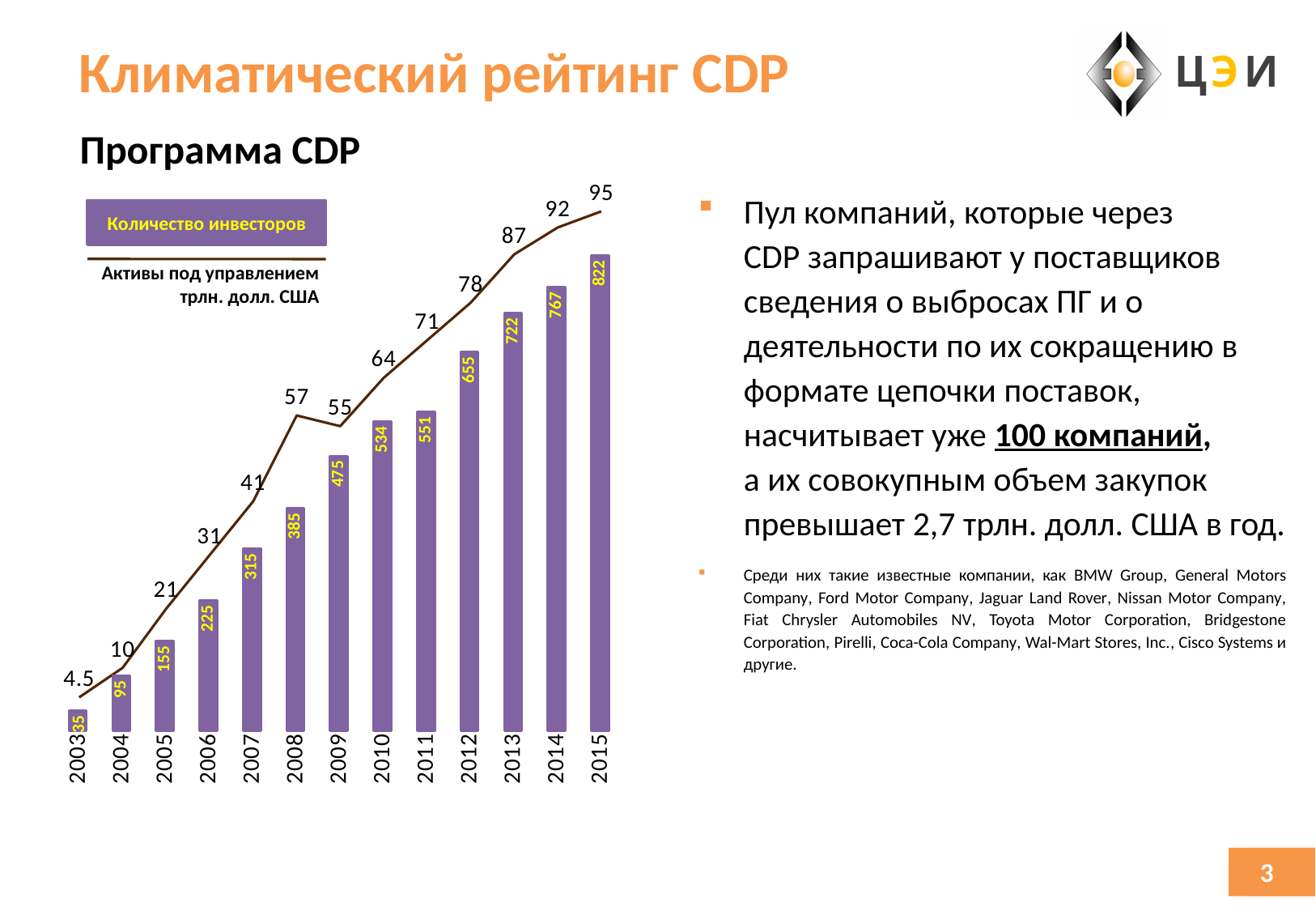
What is the difference in the number of investors between 2015 and 2014? 55 How many years are shown on the x axis? 13 What is the value of assets under management (Активы под управлением) in 2008? 57 How many series does the legend list? 2 What kind of chart is used for the number of investors series? bar chart What is the difference in assets under management between 2015 and 2003? 90.5 Which year has the highest number of investors? 2015 Which year has the lowest value of assets under management? 2003 What is the number of investors (Количество инвесторов) in 2010? 534 What unit is given for the assets under management series? трлн. долл. США Which is larger, the assets under management in 2008 or in 2009? 2008 Does the number of investors rise or fall from 2003 to 2015? rise